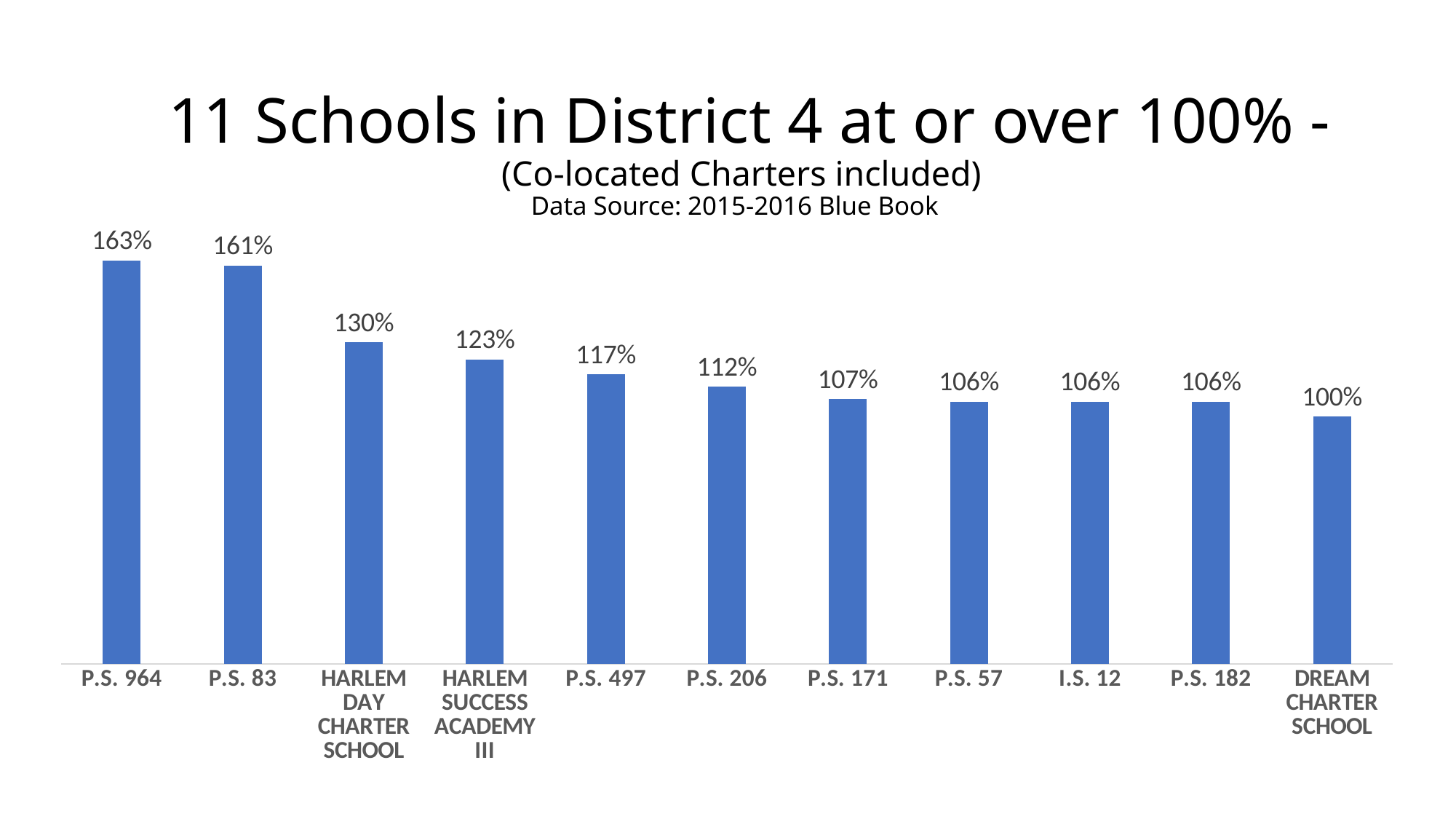
What is the value for Dream Charter School? 100% What is the value for Harlem Success Academy III? 123% What is the value for P.S. 964? 163% Do the values rise or fall from left to right across the chart? Fall What is the difference between the values for Harlem Day Charter School and P.S. 497? 13% Which school has the lowest value? Dream Charter School What is the difference between the values for P.S. 964 and P.S. 83? 2% Which is larger, the value for P.S. 171 or the value for P.S. 206? P.S. 206 How many schools are shown in the chart? 11 What is the value for P.S. 206? 112% Which school has the highest value? P.S. 964 What kind of chart is shown on the slide? Bar chart